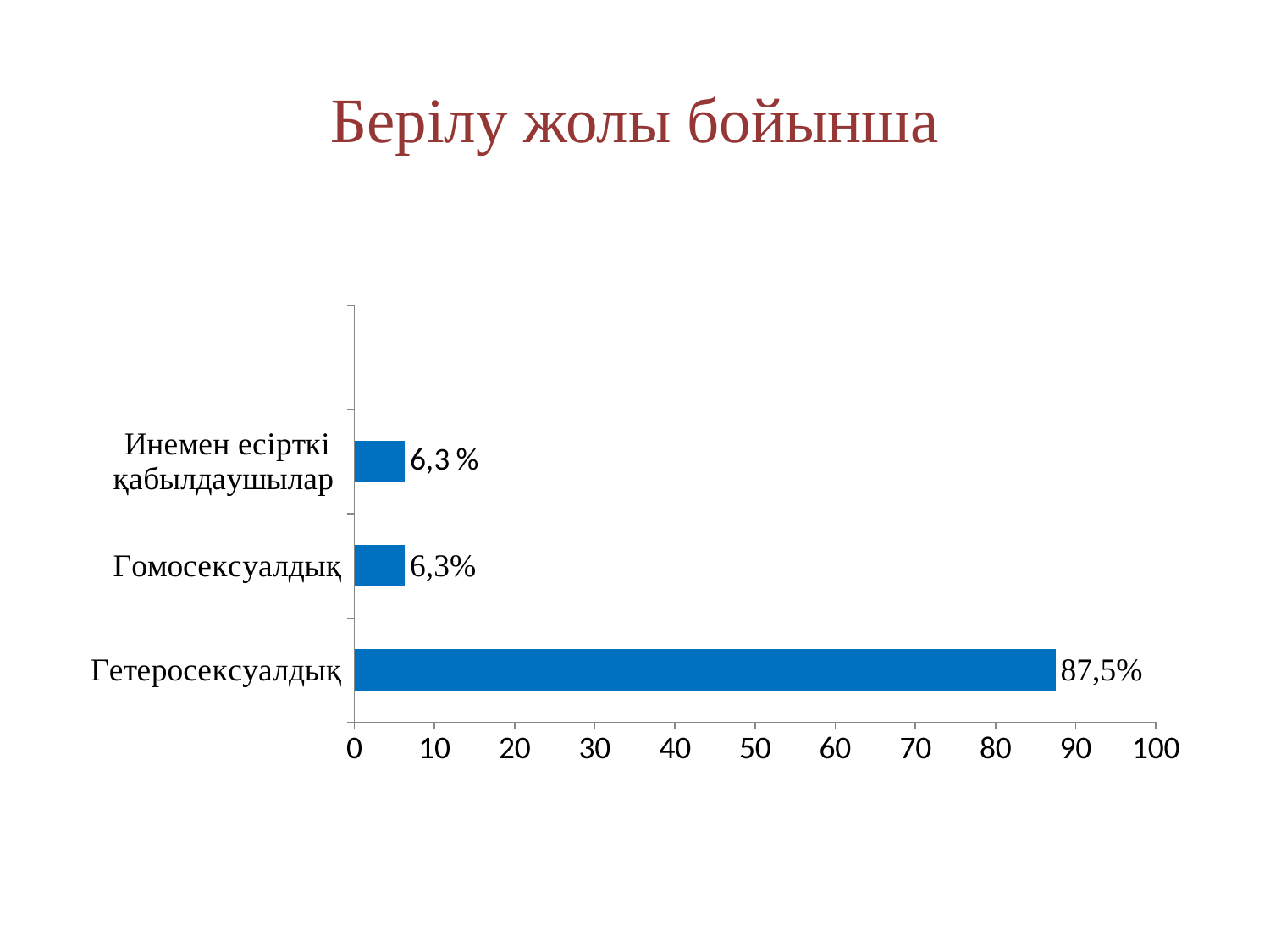
Which category has the highest value? Гетеросексуалдық Is the value for Гомосексуалдық greater or less than 10? less What is the title of the slide? Берілу жолы бойынша What is the maximum value shown on the horizontal axis? 100 Is the value for Гетеросексуалдық greater or less than 80? greater How many categories are shown in the chart? 3 What is the value for Гетеросексуалдық? 87,5% What is the value for Инемен есірткі қабылдаушылар? 6,3 % What is the value for Гомосексуалдық? 6,3% What kind of chart is shown on the slide? bar chart What is the difference between the values for Гетеросексуалдық and Гомосексуалдық? 81,2% Which is larger, the value for Гетеросексуалдық or the value for Инемен есірткі қабылдаушылар? Гетеросексуалдық